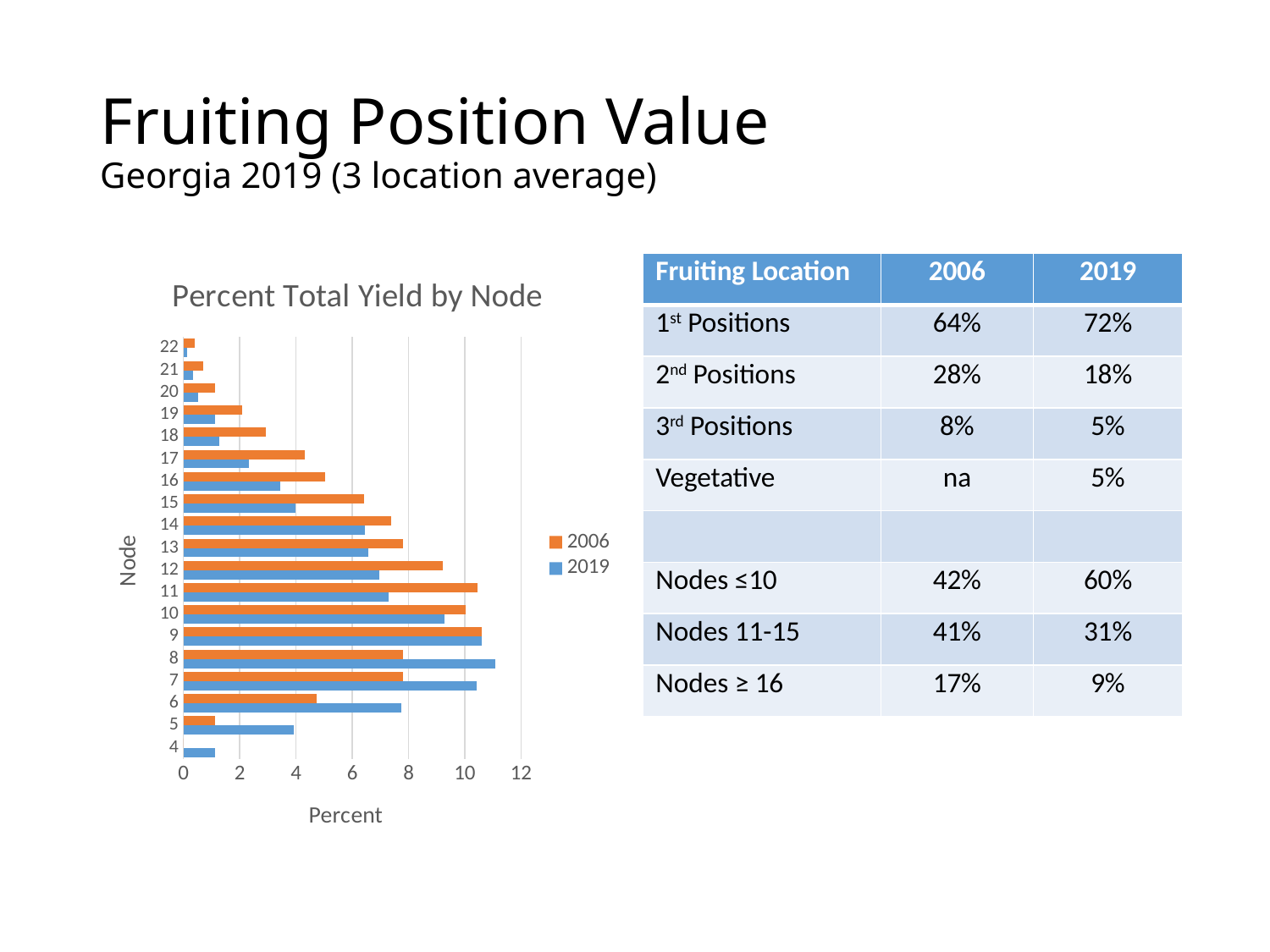
Which two series are listed in the chart's legend? 2006 and 2019 Is the 2019 value for node 8 greater or less than 10? greater Is the 2019 value for node 10 greater or less than 8? greater Which node has the highest 2019 value in the chart? 8 How many nodes are plotted on the chart's y axis? 19 For node 6, which series has the larger value, 2006 or 2019? 2019 How many series does the chart's legend list? 2 What kind of chart is shown on the slide? bar chart Do the 2006 values generally rise or fall going from node 16 up to node 22? fall For node 18, which series has the larger value, 2006 or 2019? 2006 Is the 2006 value for node 6 greater or less than 6? less What is the title of the chart on the slide? Percent Total Yield by Node